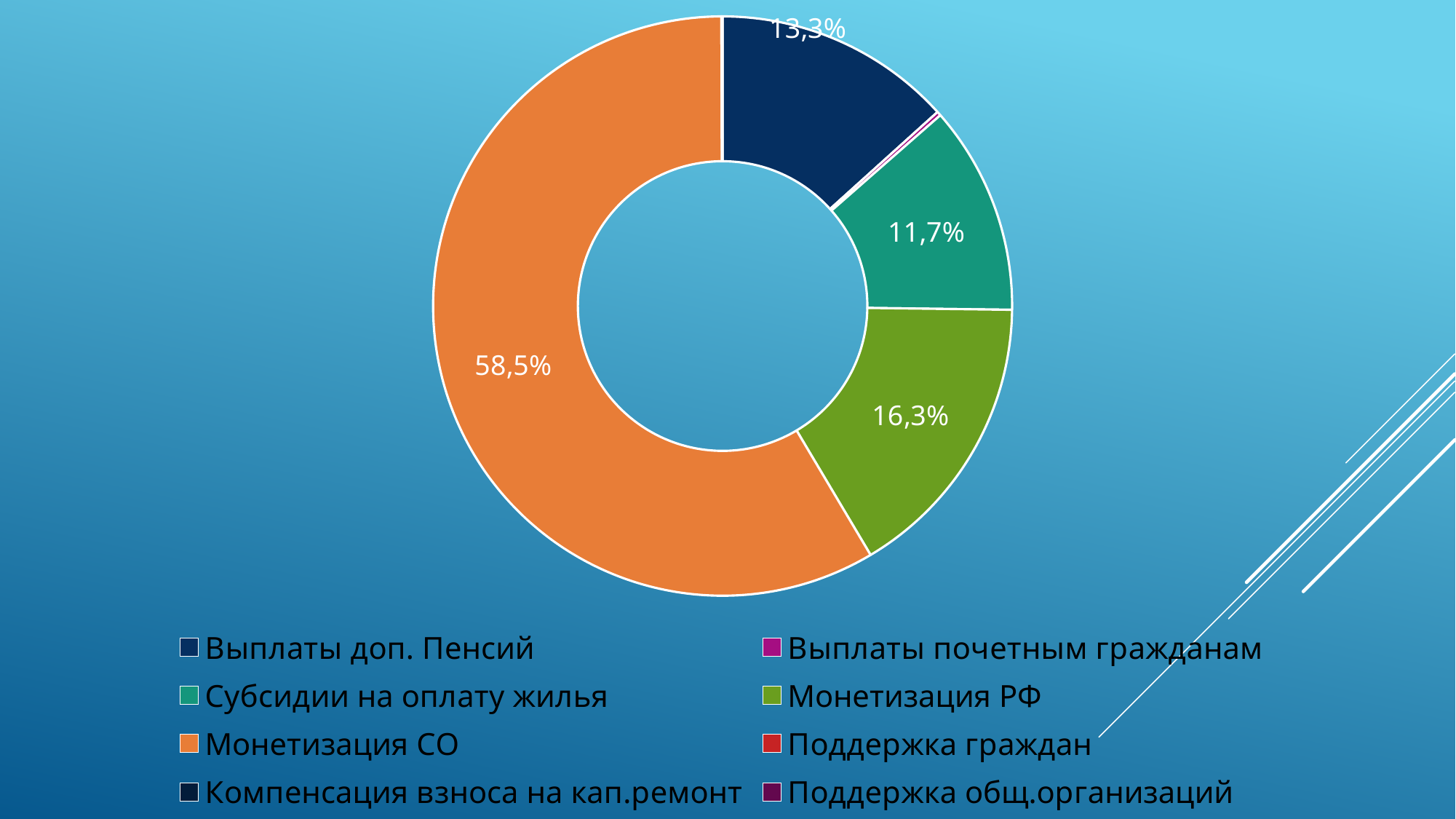
How many categories does the legend list? 8 What is the difference in percentage points between Выплаты доп. Пенсий and Субсидии на оплату жилья? 1,6 What percentage is shown for Монетизация РФ? 16,3% Which category has the largest slice of the chart? Монетизация СО Which is larger, the slice for Монетизация РФ or the slice for Выплаты доп. Пенсий? Монетизация РФ What type of chart is shown on the slide? doughnut (pie) chart What share of the doughnut chart does Монетизация СО account for? 58,5% Is the share for Монетизация СО greater or less than 50%? greater What percentage is shown for Выплаты доп. Пенсий? 13,3% What colour is the slice for Монетизация СО? orange What percentage is shown for Субсидии на оплату жилья? 11,7% What is the difference in percentage points between Монетизация СО and Монетизация РФ? 42,2